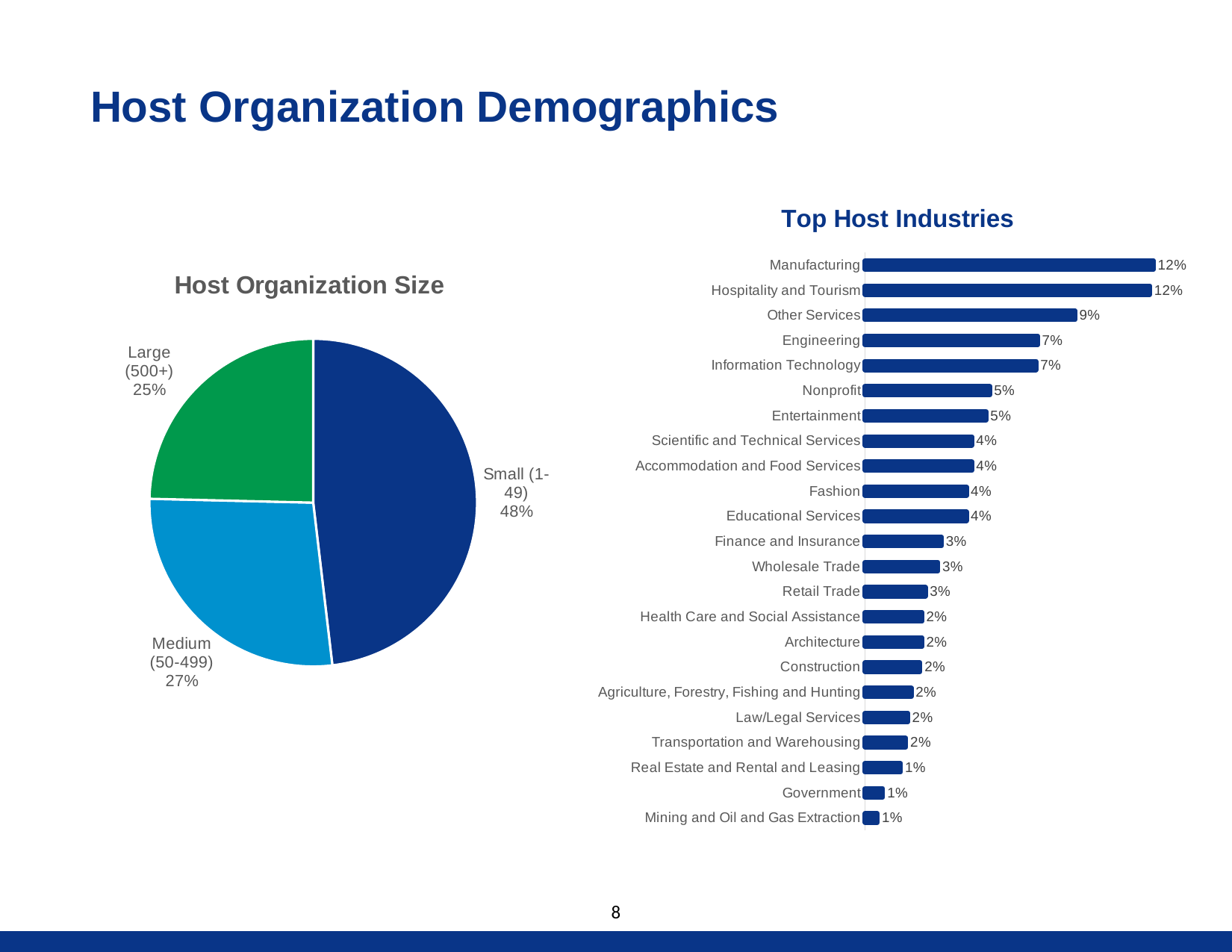
In the Top Host Industries chart, which is larger, Information Technology or Retail Trade? Information Technology In the Host Organization Size chart, which category has the largest share? Small (1-49) In the Top Host Industries chart, what is the value for Other Services? 9% What kind of chart is Host Organization Size? Pie chart In the Host Organization Size chart, how many slices does the pie have? 3 In the Host Organization Size chart, what percentage is Medium (50-499)? 27% In the Top Host Industries chart, what is the difference between Manufacturing and Nonprofit? 7% In the Host Organization Size chart, which category has the smallest share? Large (500+) In the Top Host Industries chart, what is the value for Engineering? 7% In the Top Host Industries chart, how many industries are listed? 23 In the Host Organization Size chart, what share of host organizations are Small (1-49)? 48% What kind of chart is Top Host Industries? Bar chart